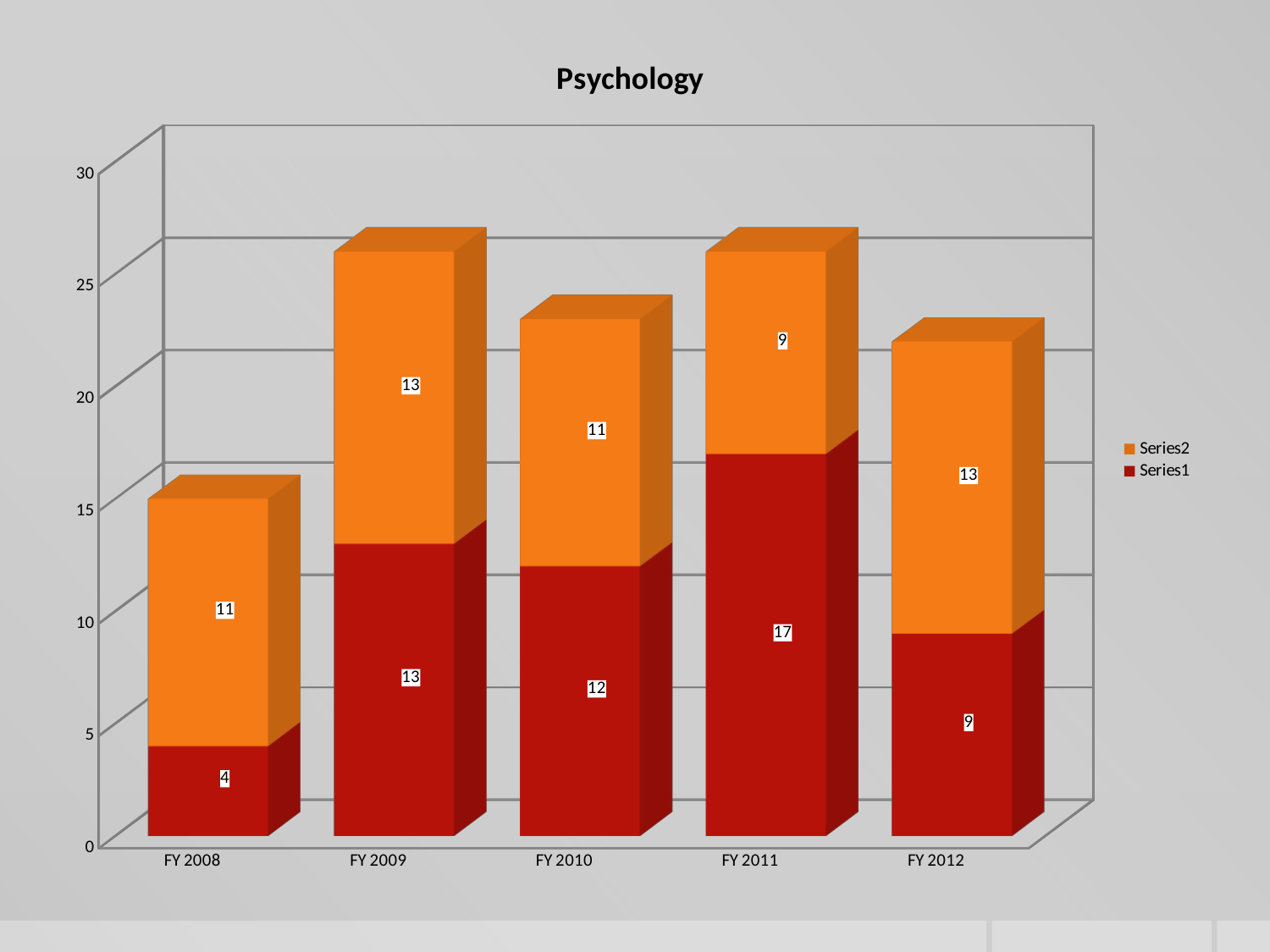
How many series does the legend list? 2 What is the Series1 value for FY 2012? 9 How many fiscal years are shown on the x axis? 5 What is the Series1 value for FY 2011? 17 Which fiscal year has the highest Series1 value? FY 2011 Which fiscal year has the lowest Series1 value? FY 2008 What is the total of the stacked bar for FY 2008? 15 What is the difference between the Series1 values for FY 2011 and FY 2008? 13 What is the Series2 value for FY 2008? 11 Which fiscal year has the lowest Series2 value? FY 2011 What is the total of the stacked bar for FY 2009? 26 Which is larger, the Series1 value for FY 2010 or the Series1 value for FY 2012? FY 2010